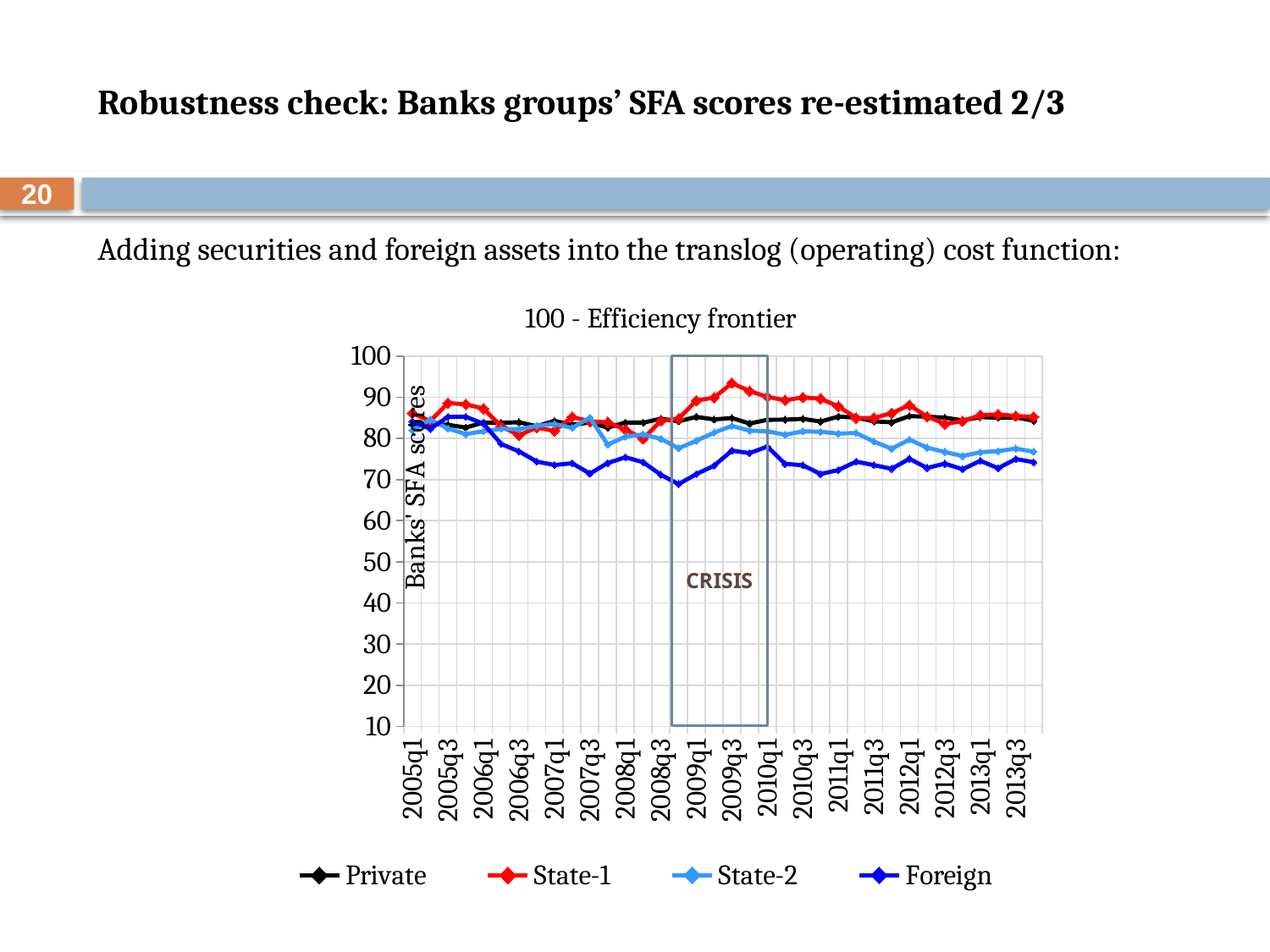
Which series has the lowest value at 2009q1? Foreign What is the title of the chart? 100 - Efficiency frontier Does the Foreign series rise or fall from 2005q1 to 2009q1? Fall How many series does the legend list? 4 Is the value for Foreign at 2009q1 greater or less than 80? less What kind of chart is shown on the slide? Line chart Is the value for Foreign at 2007q3 greater or less than 80? less Which series has the highest value at 2009q3? State-1 What label is written inside the boxed region of the chart? CRISIS Is the value for State-1 at 2009q3 greater or less than 90? greater At 2013q3, which is larger: the value for Private or the value for Foreign? Private